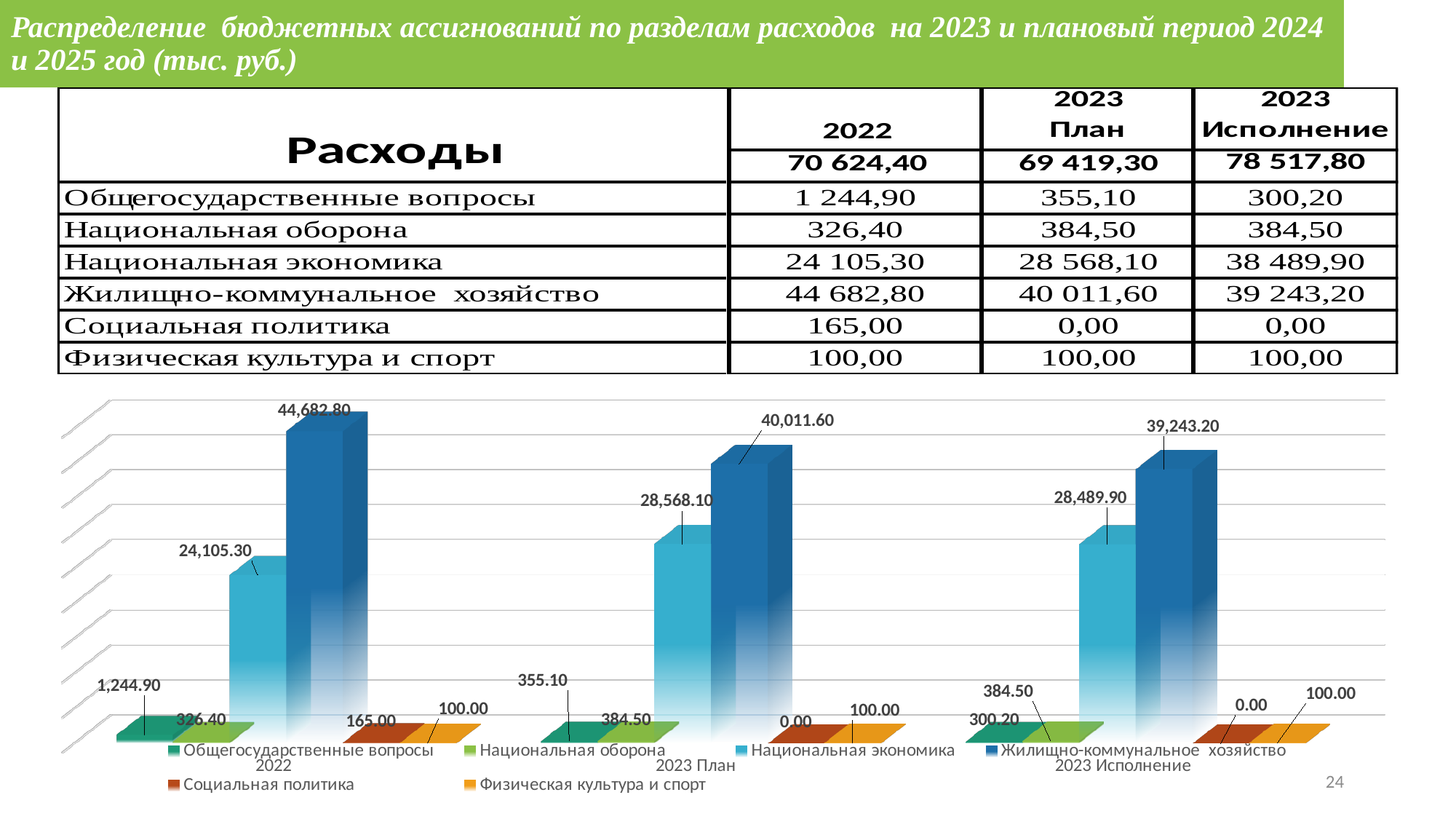
In the chart, what is the value for Общегосударственные вопросы in 2022? 1,244.90 What kind of chart is shown at the bottom of the slide? bar chart In the chart, what is the difference between Жилищно-коммунальное хозяйство in 2022 and in 2023 План? 4,671.20 How many category groups are shown along the x axis of the chart? 3 In the chart, what is the value for Национальная экономика in 2023 План? 28,568.10 In the chart, which is larger for 2023 План: Жилищно-коммунальное хозяйство or Национальная экономика? Жилищно-коммунальное хозяйство Which series has the highest value in the 2022 group of the chart? Жилищно-коммунальное хозяйство Does the value for Жилищно-коммунальное хозяйство rise or fall across the three groups from 2022 to 2023 Исполнение in the chart? fall How many series does the chart legend list? 6 In the chart, what is the value for Жилищно-коммунальное хозяйство in 2023 Исполнение? 39,243.20 In the chart, what is the value for Социальная политика in 2023 План? 0.00 In the chart, what is the value for Жилищно-коммунальное хозяйство in 2022? 44,682.80